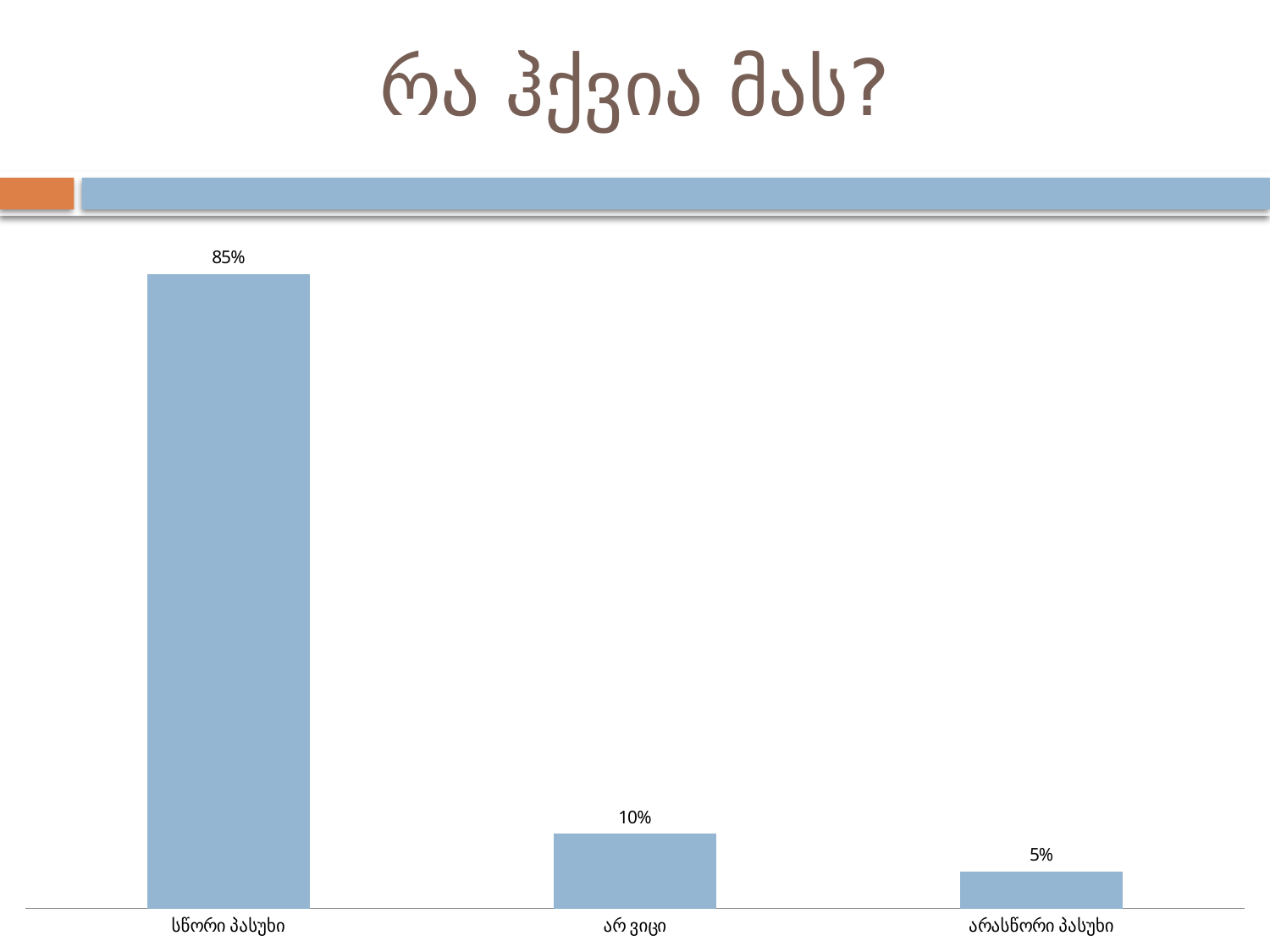
What is the value for არ ვიცი? 10% What is the value for სწორი პასუხი? 85% Which is larger, the value for არ ვიცი or the value for არასწორი პასუხი? არ ვიცი What is the difference between the values for სწორი პასუხი and არ ვიცი? 75% How many categories are shown in the chart? 3 What is the difference between the values for არ ვიცი and არასწორი პასუხი? 5% Do the values rise or fall from left to right along the x axis? fall What is the title of the slide? რა ჰქვია მას? What is the value for არასწორი პასუხი? 5% Which category has the highest value? სწორი პასუხი What kind of chart is shown on the slide? bar chart Which category has the lowest value? არასწორი პასუხი